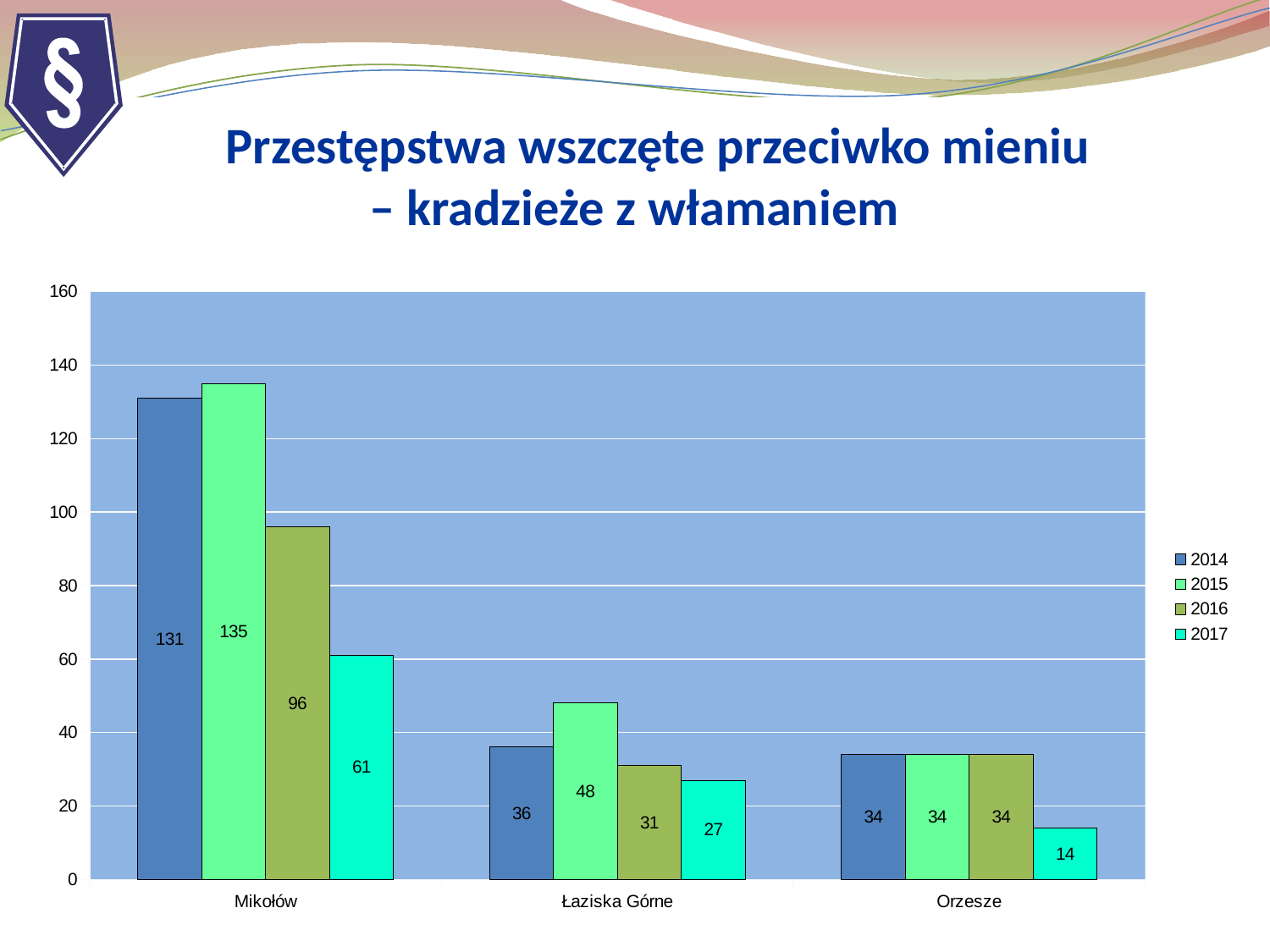
Is the 2016 value for Mikołów greater or less than 100? less What kind of chart is shown on the slide? bar chart What is the difference between the 2014 and 2017 values for Mikołów? 70 How many categories are shown on the x axis? 3 What is the value for Łaziska Górne in 2016? 31 What is the value for Mikołów in 2015? 135 How many series does the legend list? 4 Which year has the highest value for Mikołów? 2015 What is the value for Orzesze in 2017? 14 Which year has the lowest value for Łaziska Górne? 2017 Which is larger: the 2015 value for Łaziska Górne or the 2015 value for Orzesze? Łaziska Górne Do the values for Orzesze rise or fall from 2016 to 2017? fall